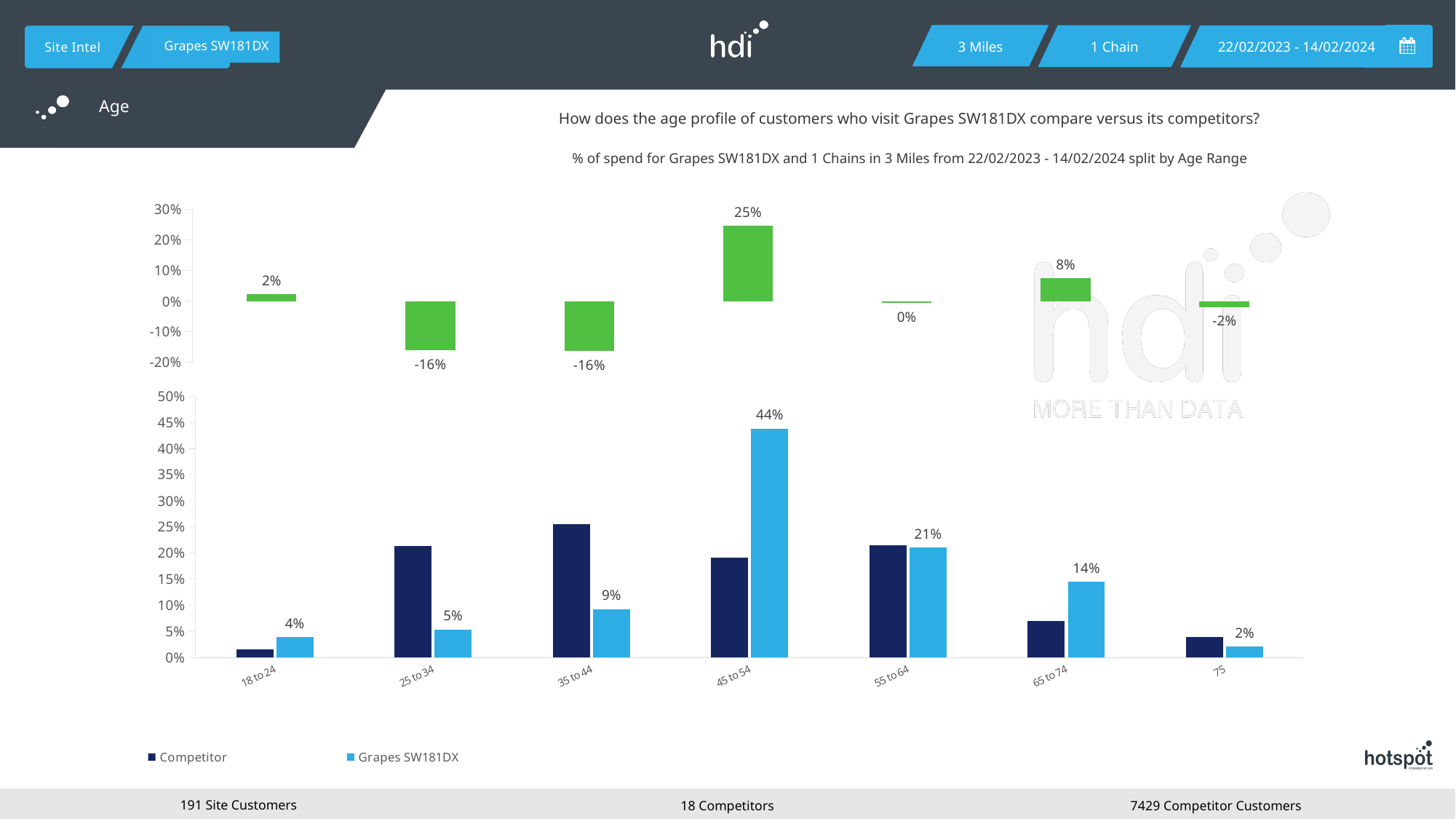
In the bottom chart, which age range has the highest value for Grapes SW181DX? 45 to 54 In the bottom chart, is the Competitor value for 35 to 44 greater or less than 20%? greater In the bottom chart, for the 35 to 44 age range, which series has the larger value, Competitor or Grapes SW181DX? Competitor In the top chart, which age range has the highest value? 45 to 54 In the bottom chart, which age range has the lowest value for Grapes SW181DX? 75 In the bottom chart, what is the difference between the Grapes SW181DX values for 45 to 54 and 55 to 64? 23 percentage points How many age range categories are shown on the x axis of the bottom chart? 7 In the top chart, what is the value shown for the 55 to 64 age range? 0% In the top chart, what is the value shown for the 65 to 74 age range? 8% In the bottom chart, what is the value for Grapes SW181DX in the 45 to 54 age range? 44% In the bottom chart, is the Competitor value for 18 to 24 greater or less than 5%? less How many series does the legend of the bottom chart list? 2